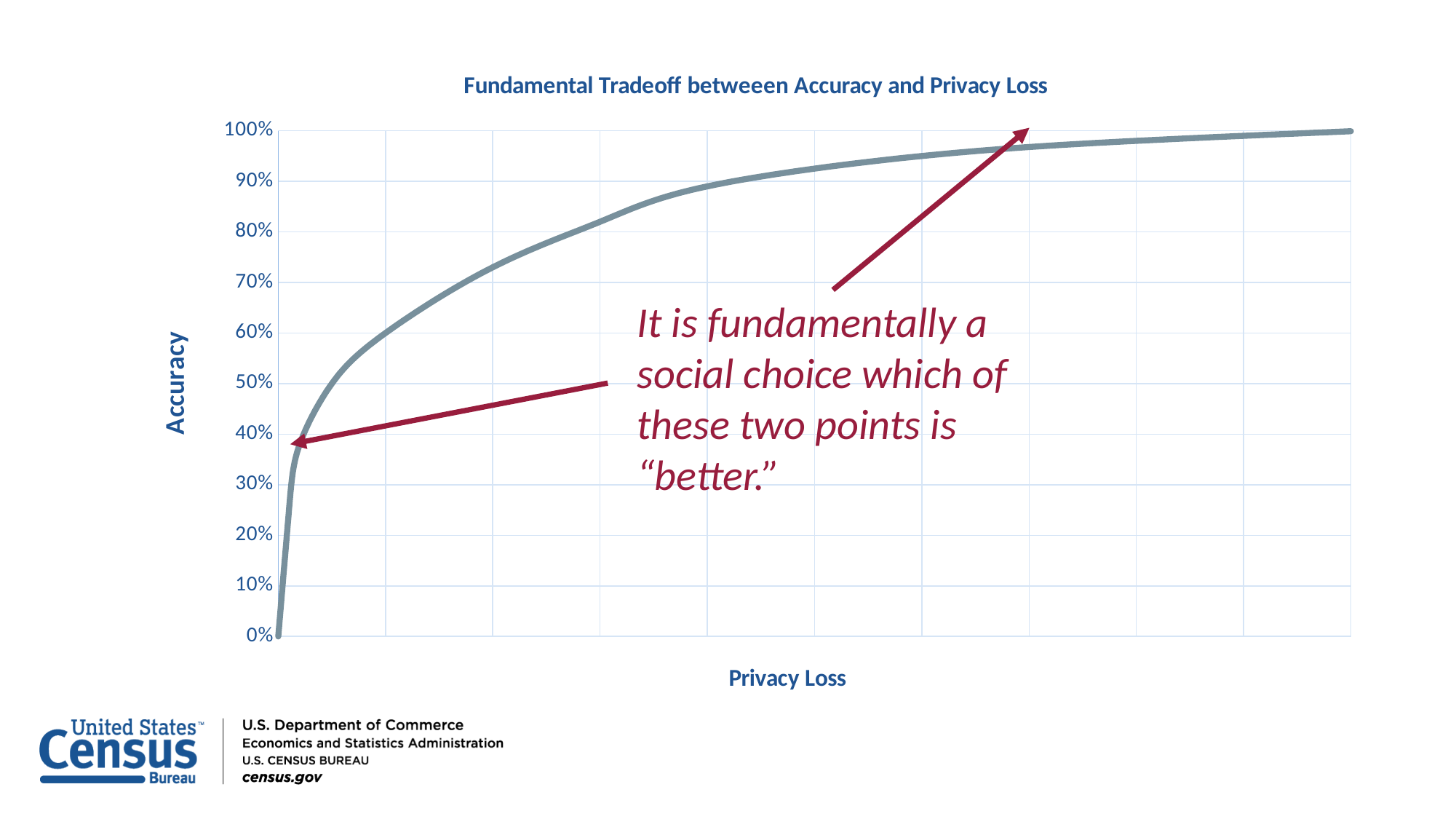
As Privacy Loss increases along the x axis, does Accuracy rise or fall? rise Is the Accuracy at the point marked by the lower arrow greater or less than 50%? less What is the title of the chart? Fundamental Tradeoff betweeen Accuracy and Privacy Loss How many tick labels are shown on the Accuracy axis? 11 Is the Accuracy at the point marked by the upper arrow greater or less than 90%? greater What kind of chart is shown on the slide? line chart Is the Accuracy at the far right end of the curve greater or less than 90%? greater Which of the two arrow-marked points has the higher Accuracy, the upper one or the lower one? the upper one What is the label of the vertical axis? Accuracy What is the highest value shown on the Accuracy axis? 100%